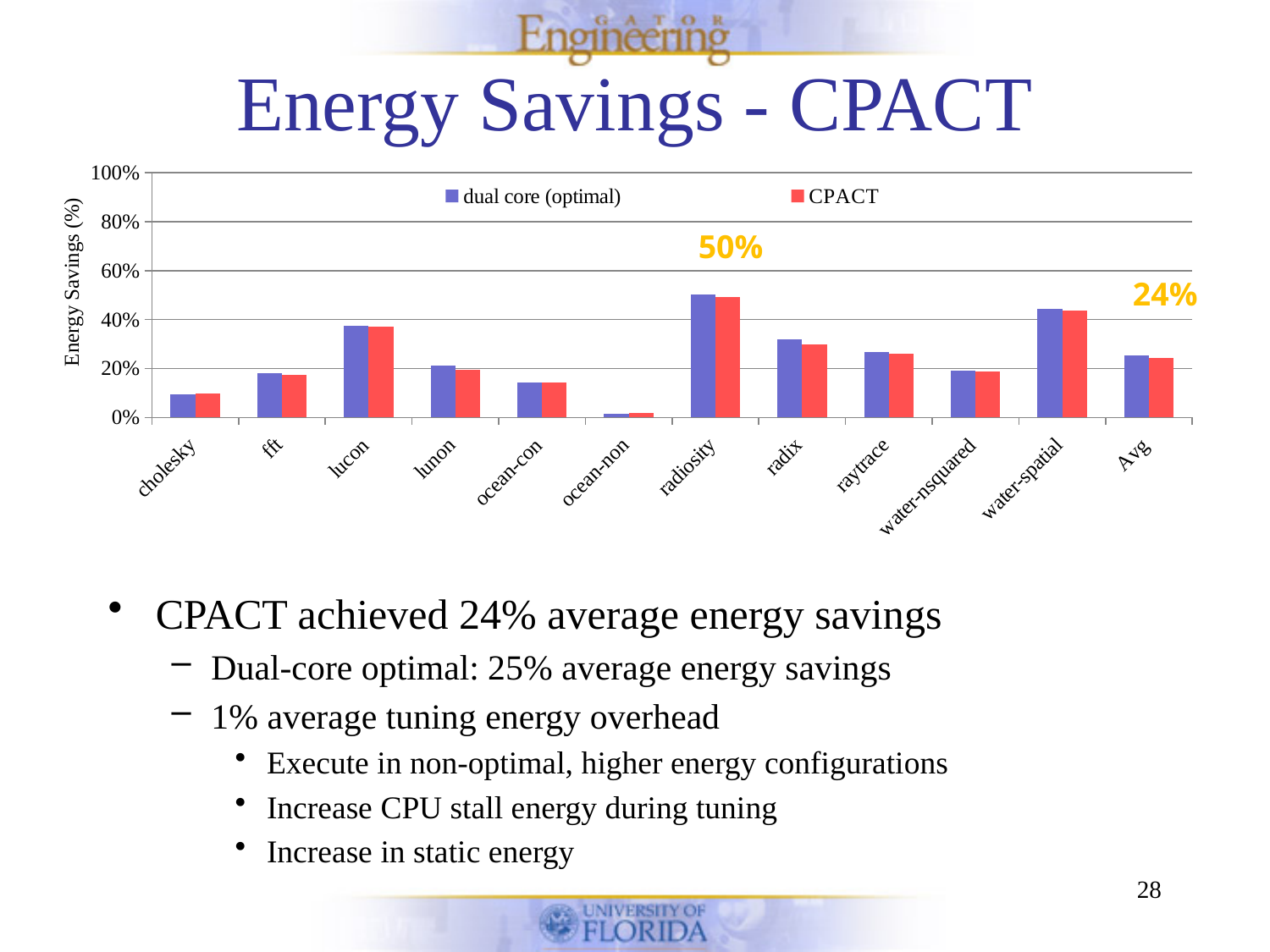
What is the label on the y axis? Energy Savings (%) Is the CPACT value for radix greater or less than 20%? greater Is the CPACT value for cholesky greater or less than 20%? less What is the average (Avg) energy savings for CPACT, as annotated on the chart? 24% Is the CPACT value for radiosity greater or less than 40%? greater Which category has the lowest energy savings for CPACT? ocean-non What kind of chart is shown on the slide? bar chart How many series does the legend list? 2 Which has the larger CPACT energy savings, lucon or lunon? lucon Which category has the highest energy savings for CPACT? radiosity How many benchmark categories are shown along the x axis? 12